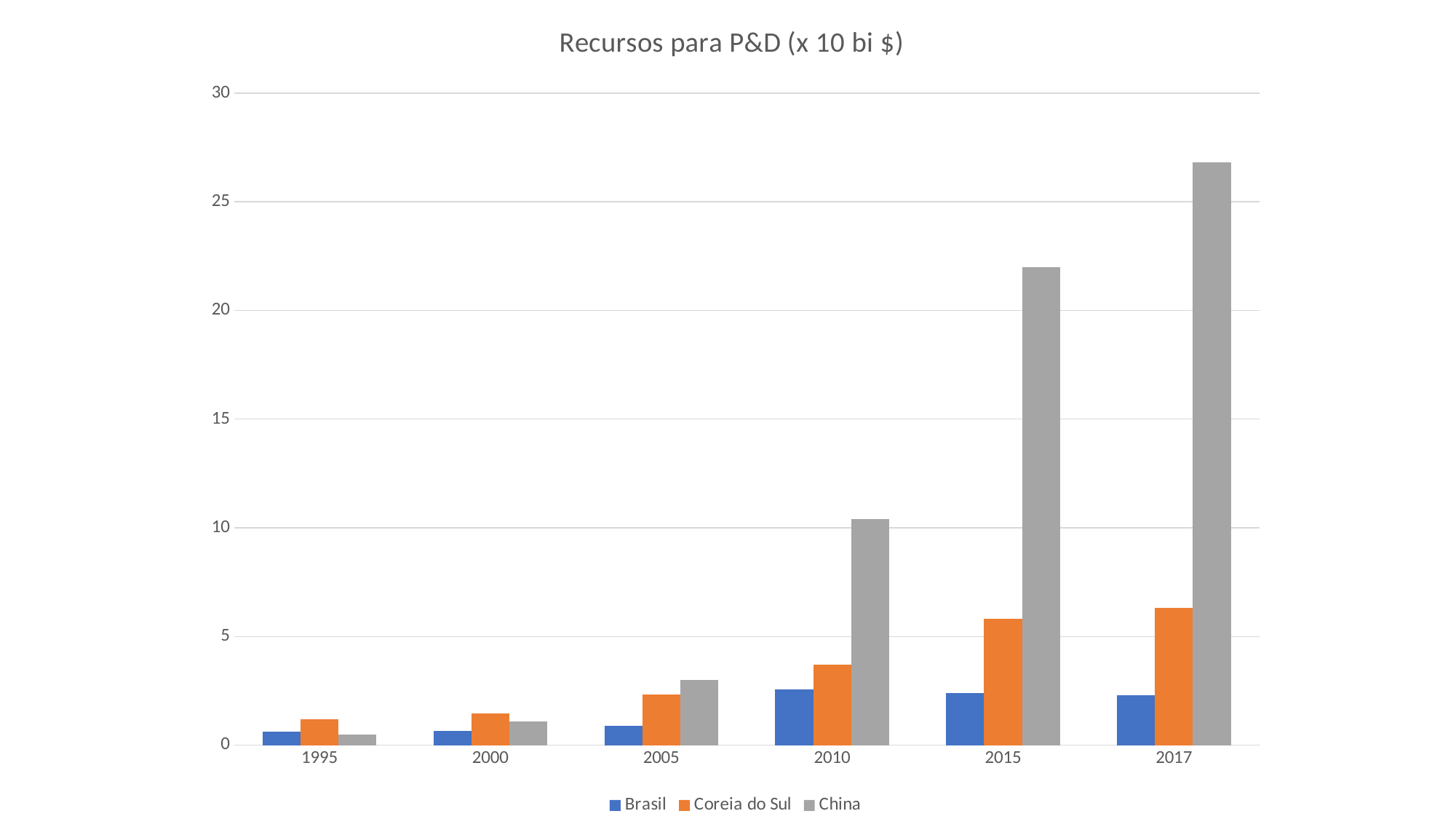
Which series has the lowest value in 2015? Brasil In which year is the value for China highest? 2017 Which series has the highest value in 2017? China Is the value for China in 2015 greater or less than 20? greater How many series does the legend list? 3 Is the value for China in 2017 greater or less than 25? greater What is the title of the chart? Recursos para P&D (x 10 bi $) What kind of chart is shown on the slide? bar chart Which is larger in 1995, the value for Brasil or the value for Coreia do Sul? Coreia do Sul Does the value for China rise or fall from 1995 to 2017? rise Is the value for Coreia do Sul in 2017 greater or less than 10? less How many years are shown on the x axis? 6